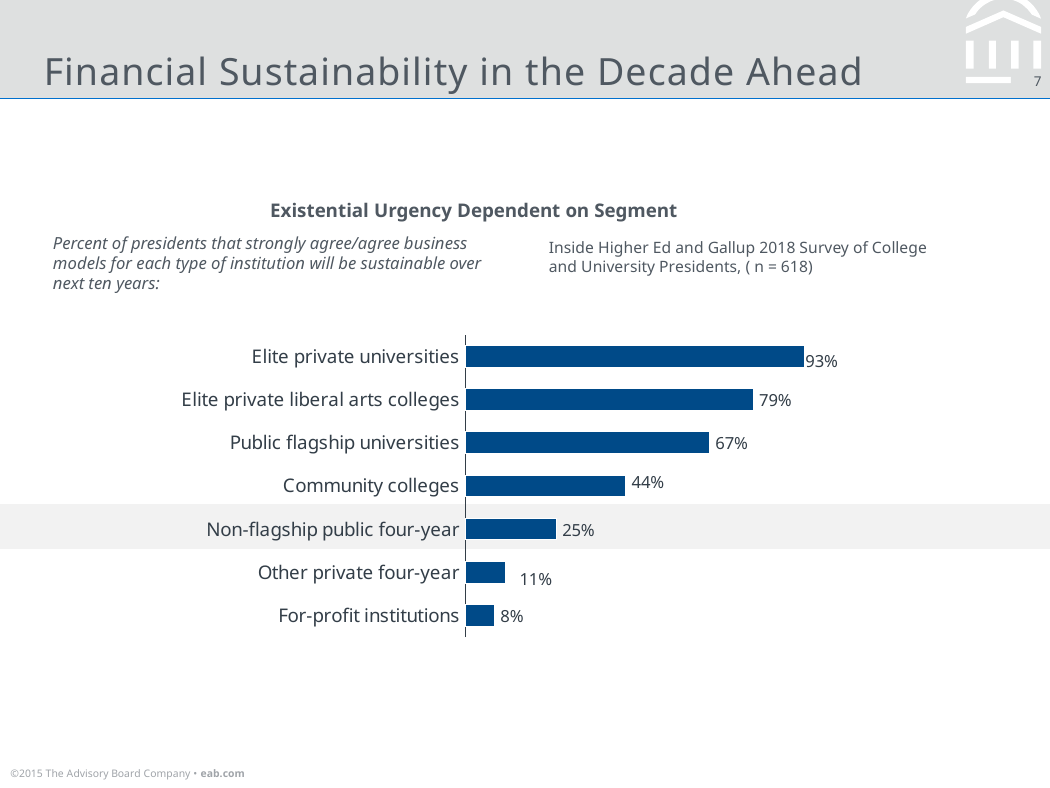
What kind of chart is shown on the slide? Bar chart Which is larger, the value for community colleges or the value for non-flagship public four-year institutions? Community colleges What is the value shown for community colleges? 44% Which institution type has the lowest percentage? For-profit institutions What is the difference between the values for elite private liberal arts colleges and public flagship universities? 12% What is the difference between the values for elite private universities and for-profit institutions? 85% What percentage of presidents at elite private universities strongly agree/agree their business model will be sustainable? 93% What is the value shown for non-flagship public four-year institutions? 25% What is the title of the chart? Existential Urgency Dependent on Segment What is the value shown for other private four-year institutions? 11% Which institution type has the highest percentage? Elite private universities How many institution types are shown in the chart? 7